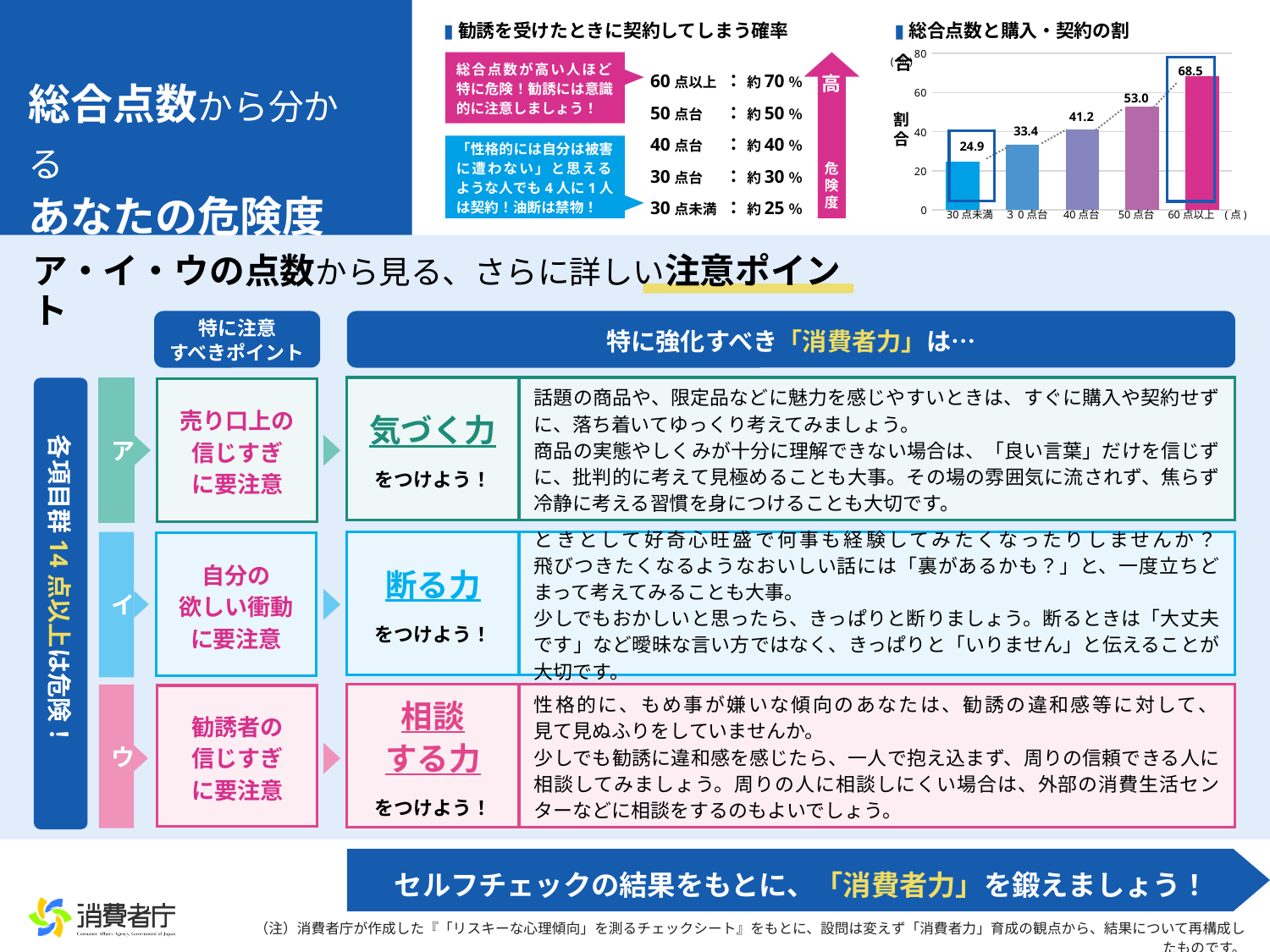
What is the value for 60点以上 in the chart 総合点数と購入・契約の割合? 68.5 What is the difference between the values for 60点以上 and 30点未満 in the chart 総合点数と購入・契約の割合? 43.6 What is the value for 30点未満 in the chart 総合点数と購入・契約の割合? 24.9 Which category has the lowest value in the chart 総合点数と購入・契約の割合? 30点未満 How many categories are shown on the x axis of the chart 総合点数と購入・契約の割合? 5 What is the value for 40点台 in the chart 総合点数と購入・契約の割合? 41.2 What kind of chart is 総合点数と購入・契約の割合? bar chart In the chart 総合点数と購入・契約の割合, which is larger, the value for 30点台 or the value for 50点台? 50点台 What is the difference between the values for 50点台 and 40点台 in the chart 総合点数と購入・契約の割合? 11.8 Which category has the highest value in the chart 総合点数と購入・契約の割合? 60点以上 Do the values in the chart 総合点数と購入・契約の割合 rise or fall from left to right along the x axis? rise Is the value for 50点台 in the chart 総合点数と購入・契約の割合 greater or less than 40? greater